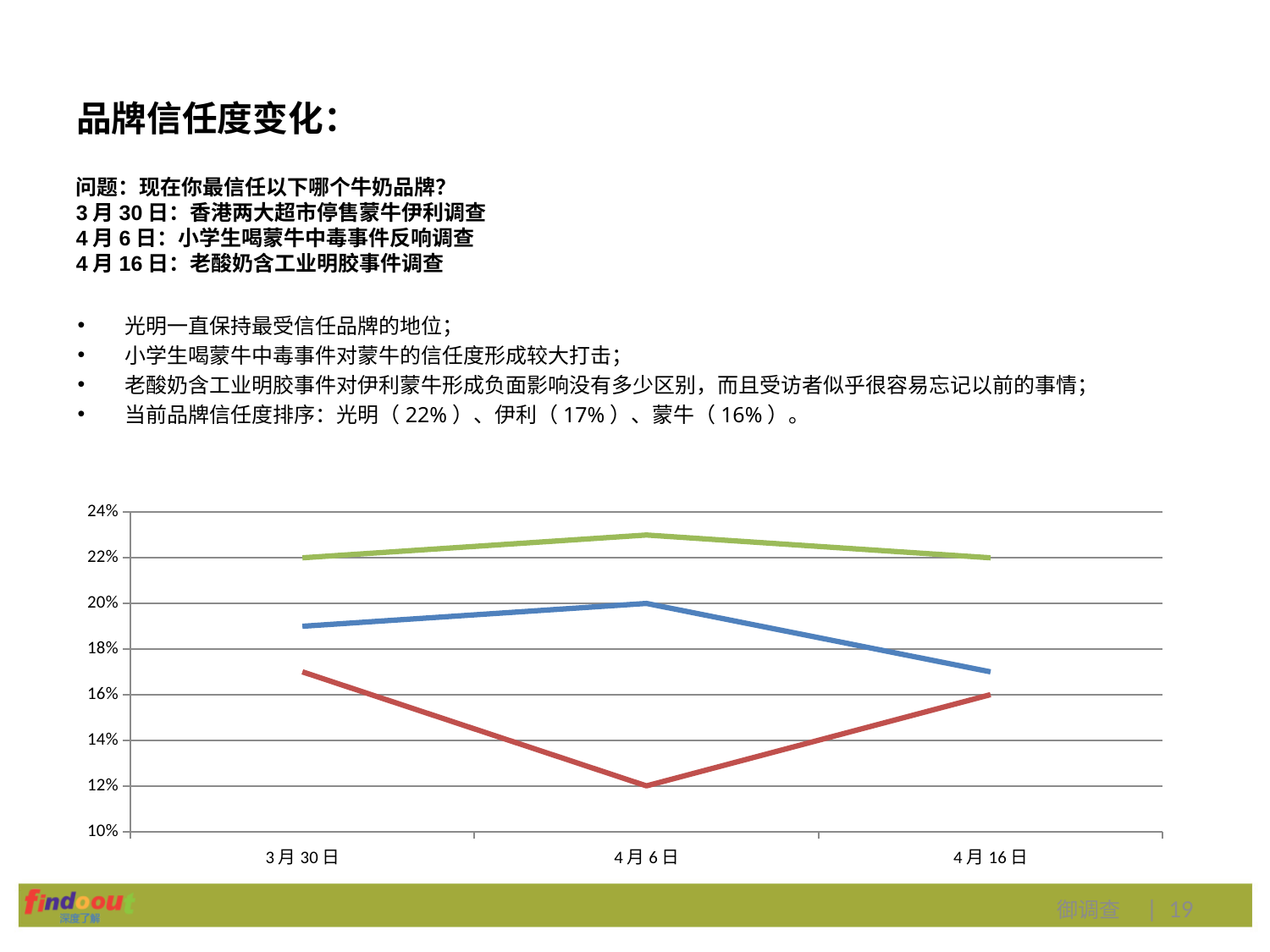
What is the value of the red line on 4月6日? 12% What is the value of the green line on 3月30日? 22% What is the value of the red line on 4月16日? 16% How many lines are plotted on the chart? 3 Does the blue line rise or fall from 4月6日 to 4月16日? Fall What is the difference between the blue line and the red line on 4月16日? 1% How many dates are shown on the x axis of the chart? 3 What kind of chart is shown on the slide? Line chart Which line has the highest value on 4月6日? The green line What is the value of the blue line on 4月16日? 17% Is the value of the green line on 4月6日 greater or less than 22%? greater On which date is the red line at its lowest value? 4月6日